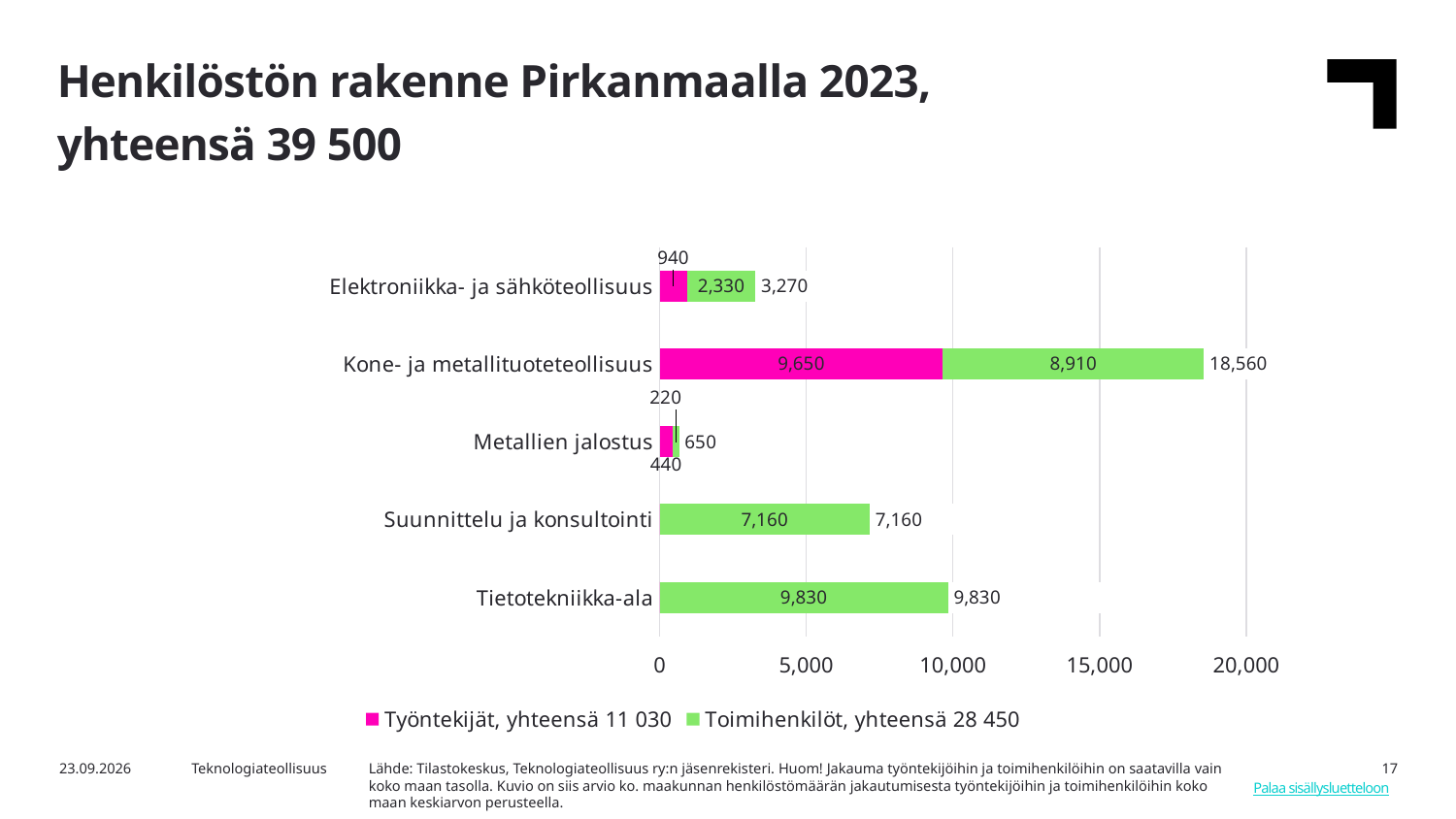
What is the Työntekijät value for Kone- ja metallituoteteollisuus? 9,650 What is the total for the Elektroniikka- ja sähköteollisuus bar? 3,270 What is the Toimihenkilöt value for Kone- ja metallituoteteollisuus? 8,910 Which category has the lowest total? Metallien jalostus Which category has the highest total? Kone- ja metallituoteteollisuus What is the difference between the totals for Tietotekniikka-ala and Suunnittelu ja konsultointi? 2,670 Which is larger: the Työntekijät value or the Toimihenkilöt value for Kone- ja metallituoteteollisuus? Työntekijät What type of chart is shown on the slide? Stacked bar chart What is the Toimihenkilöt value for Elektroniikka- ja sähköteollisuus? 2,330 What is the total for the Metallien jalostus bar? 650 How many series does the legend list? 2 How many categories are shown on the chart? 5